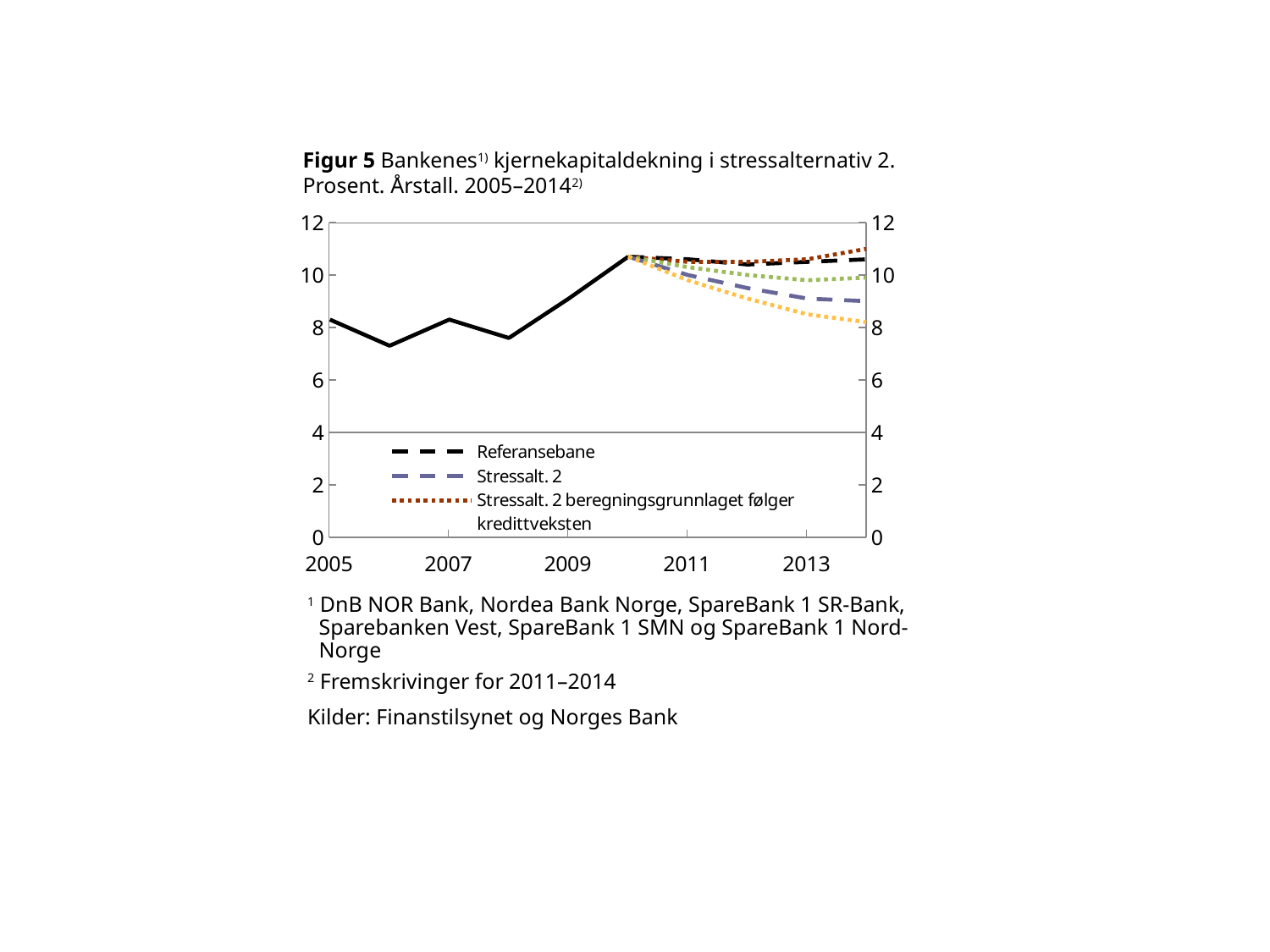
Which year between 2005 and 2010 has the highest value on the solid black line? 2010 What is the maximum value shown on the y axis? 12 Is the value for 2006 on the solid black line greater or less than 8? less Is the value for 2010 on the solid black line greater or less than 10? greater In 2014, which is higher: Referansebane or Stressalt. 2? Referansebane Which year between 2005 and 2010 has the lowest value on the solid black line? 2006 What kind of chart is shown in Figur 5? line chart How many series does the legend list? 3 Does the Stressalt. 2 line rise or fall from 2010 to 2014? fall Is the value of Referansebane in 2014 greater or less than 10? greater Does the solid black line rise or fall from 2008 to 2010? rise